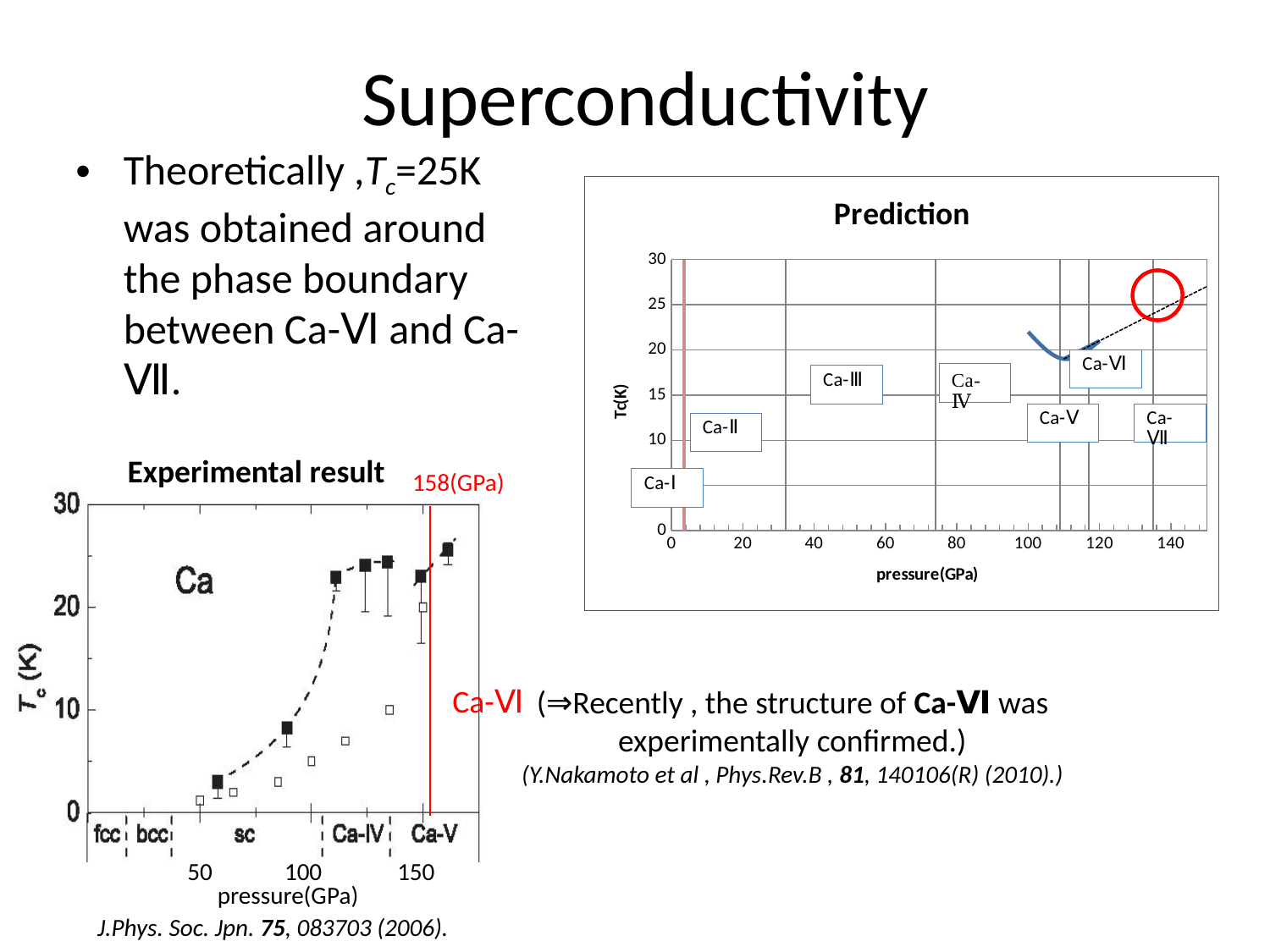
In the Prediction chart, what is the label on the x axis? pressure(GPa) In the Prediction chart, is the predicted Tc inside the red circle greater or less than 30 K? less In the Prediction chart, what is the highest value shown on the Tc(K) axis? 30 In the Experimental result chart, which element's Tc is plotted? Ca In the Experimental result chart, is the measured Tc at about 50 GPa greater or less than 10 K? less In the Experimental result chart, at what pressure is the red vertical line drawn? 158(GPa) In the Experimental result chart, how many structural phases are labelled along the pressure axis (fcc, bcc, sc, Ca-IV, Ca-V)? 5 In the Experimental result chart, does Tc generally rise or fall as pressure increases? rise In the Prediction chart, is the predicted Tc inside the red circle greater or less than 20 K? greater What kind of chart is the Experimental result chart? scatter plot In the Prediction chart, how many calcium phase regions (Ca-I to Ca-VII) are labelled? 7